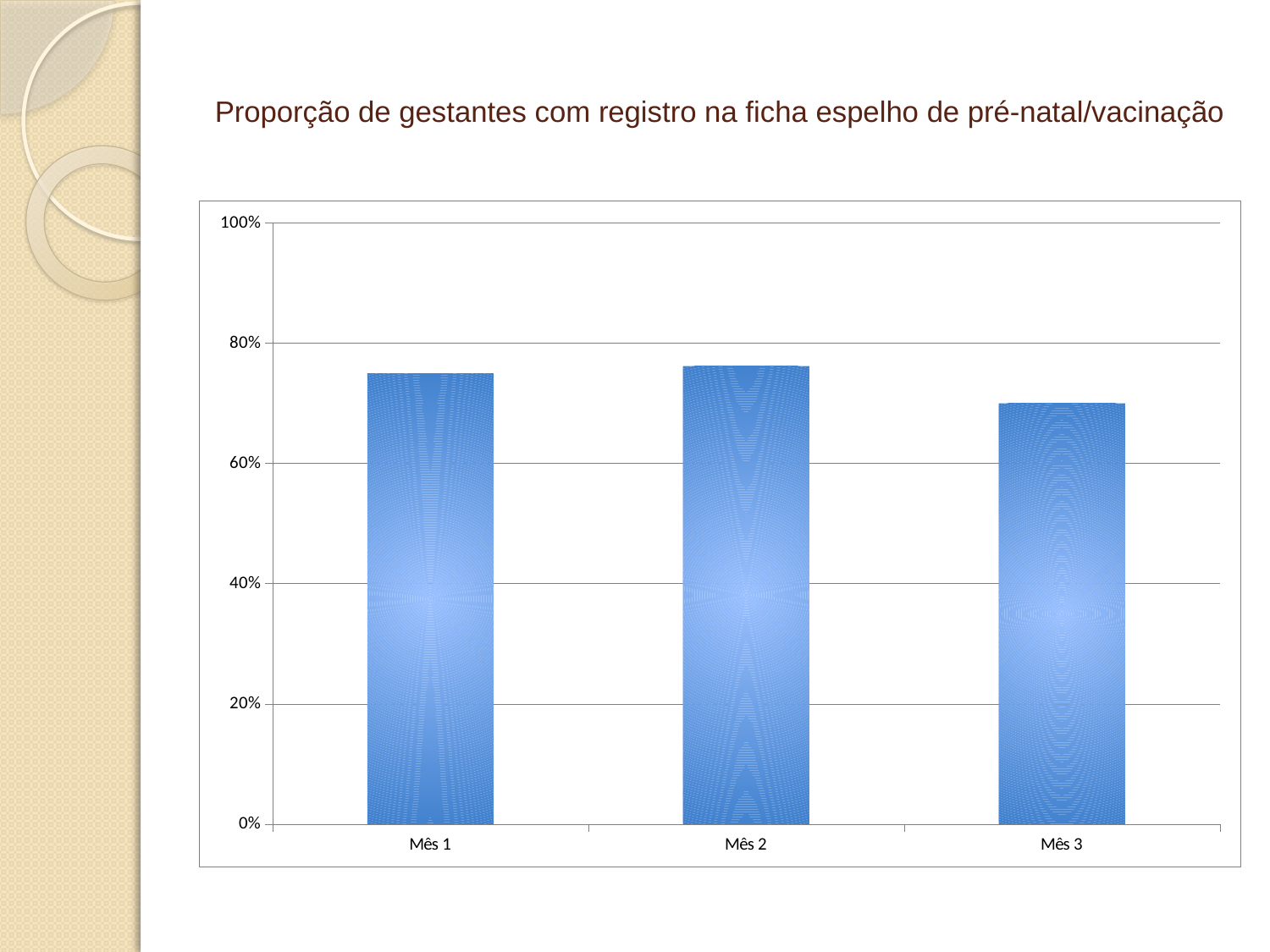
How many categories (months) are plotted on the chart? 3 What is the highest value shown on the vertical axis of the chart? 100% Is the value for Mês 3 greater or less than 80%? less Is the value for Mês 3 greater or less than 60%? greater Which is larger, the value for Mês 1 or the value for Mês 3? Mês 1 What is the title of the chart on the slide? Proporção de gestantes com registro na ficha espelho de pré-natal/vacinação Which is larger, the value for Mês 2 or the value for Mês 3? Mês 2 Which month has the lowest value on the chart? Mês 3 What kind of chart is shown on the slide? bar chart Is the value for Mês 1 greater or less than 60%? greater